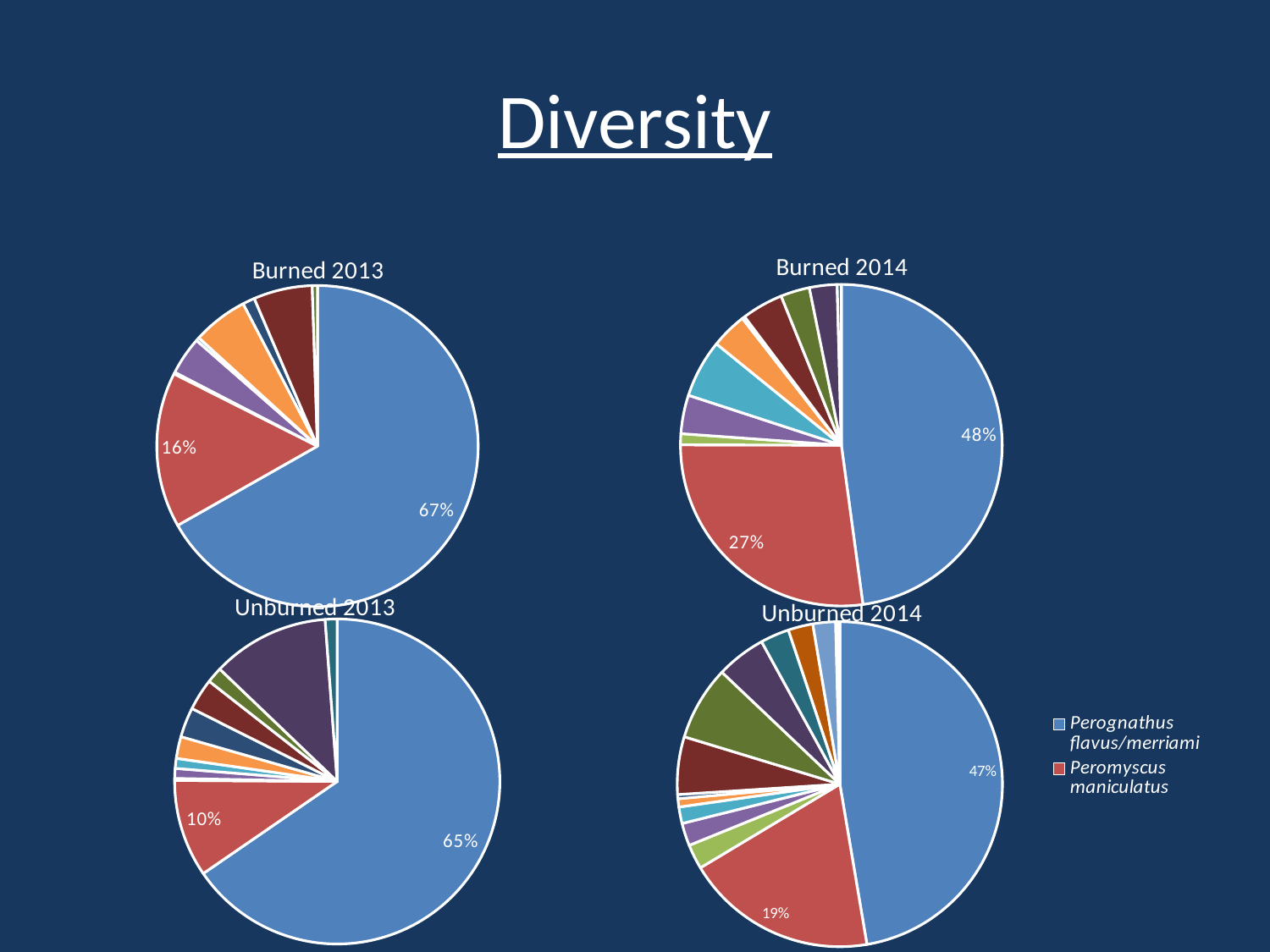
How many species does the legend on the slide list? 2 In the Unburned 2014 chart, which species has the largest slice? Perognathus flavus/merriami In the Unburned 2014 chart, what percentage is shown for the red Peromyscus maniculatus slice? 19% What kind of chart is used for the Unburned 2013 data? Pie chart In the Burned 2014 chart, what percentage is shown for the red Peromyscus maniculatus slice? 27% In the Burned 2014 chart, what percentage is shown for the blue Perognathus flavus/merriami slice? 48% In the Burned 2014 chart, what is the difference between the Perognathus flavus/merriami share and the Peromyscus maniculatus share? 21% Which chart shows a larger share for Peromyscus maniculatus: Burned 2013 or Burned 2014? Burned 2014 How many pie charts are shown on the slide? 4 In the Burned 2013 chart, what share of the pie is labelled for Perognathus flavus/merriami (the blue slice)? 67% In the Burned 2013 chart, what percentage is shown for Peromyscus maniculatus (the red slice)? 16% In the Unburned 2013 chart, what percentage is shown for the blue Perognathus flavus/merriami slice? 65%